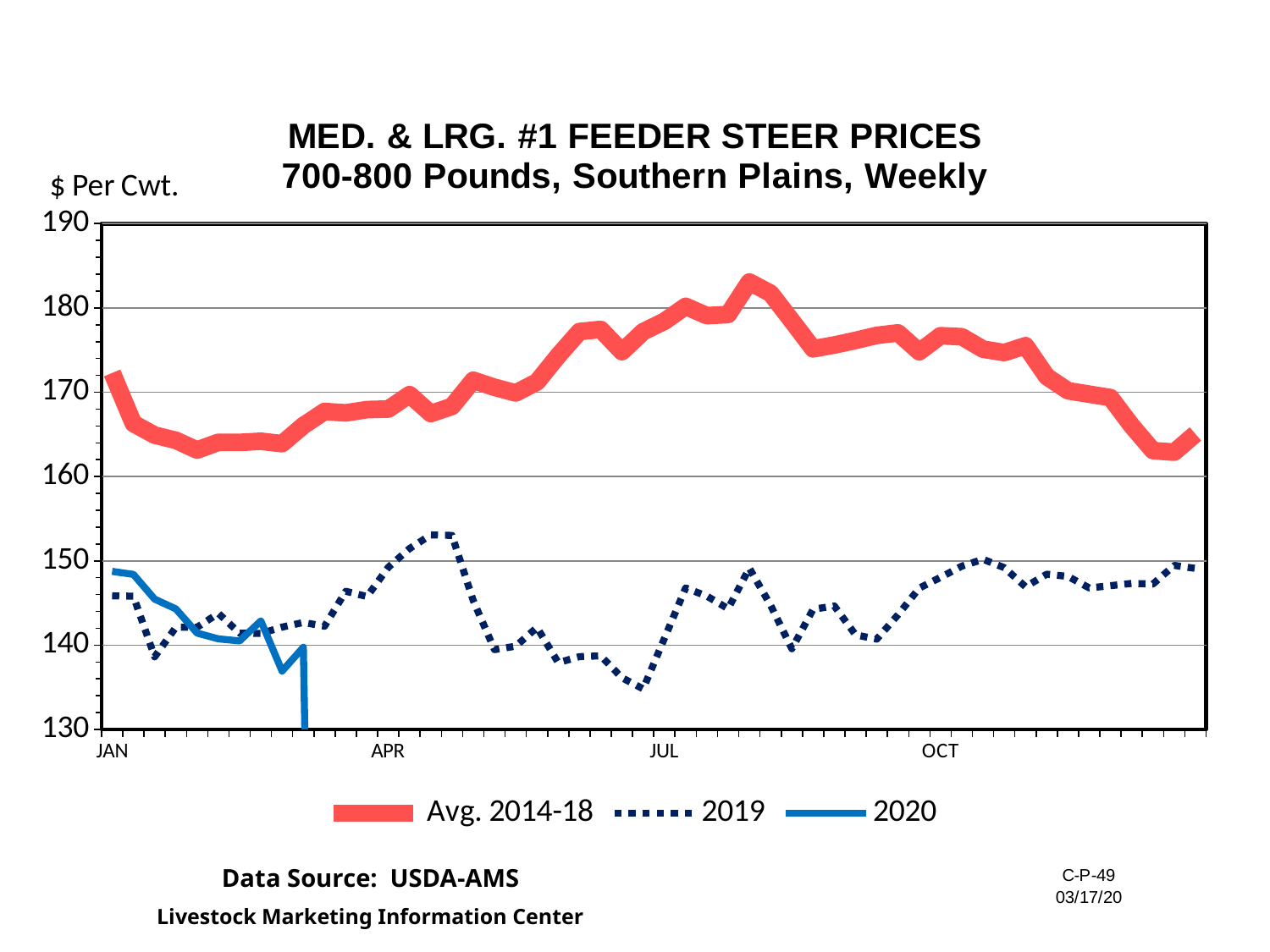
What is the unit label shown above the vertical axis? $ Per Cwt. How many series does the legend list? 3 Is the Avg. 2014-18 value in early January greater or less than 170? greater Is the 2019 value in early January greater or less than 150? less Is the peak of the Avg. 2014-18 line in August greater or less than 180? greater Which series is higher in early January, 2019 or 2020? 2020 Which series has the highest values throughout the year? Avg. 2014-18 Does the 2020 line rise or fall from January to March? fall What kind of chart is shown on the slide? line chart What are the three series listed in the legend? Avg. 2014-18, 2019, 2020